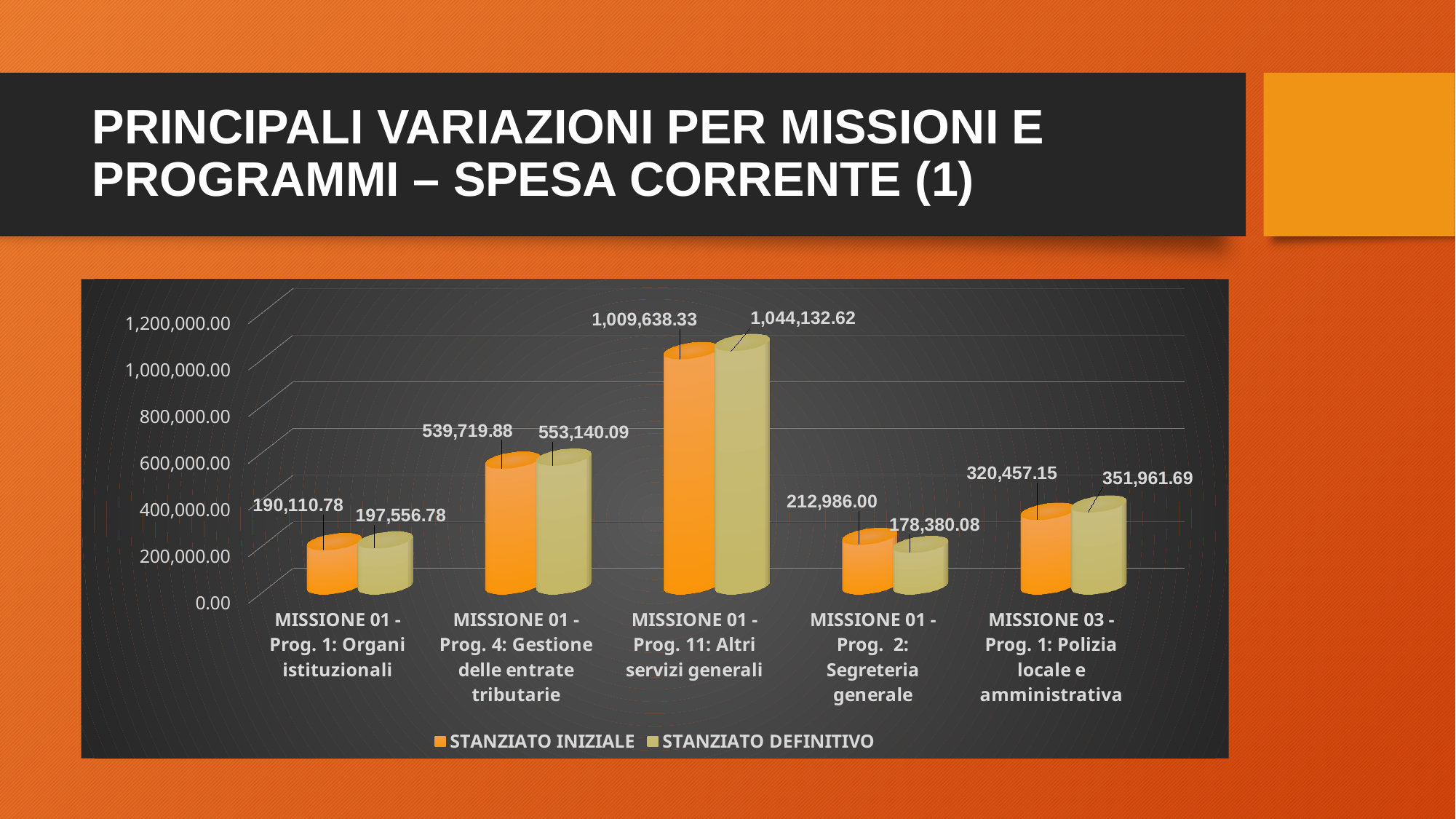
What is the STANZIATO INIZIALE value for MISSIONE 01 - Prog. 11: Altri servizi generali? 1,009,638.33 What is the difference between STANZIATO INIZIALE and STANZIATO DEFINITIVO for MISSIONE 01 - Prog. 2: Segreteria generale? 34,605.92 Which category has the lowest STANZIATO INIZIALE value? MISSIONE 01 - Prog. 1: Organi istituzionali What is the difference between STANZIATO DEFINITIVO and STANZIATO INIZIALE for MISSIONE 01 - Prog. 11: Altri servizi generali? 34,494.29 What is the STANZIATO DEFINITIVO value for MISSIONE 01 - Prog. 2: Segreteria generale? 178,380.08 For MISSIONE 01 - Prog. 2: Segreteria generale, which is larger, STANZIATO INIZIALE or STANZIATO DEFINITIVO? STANZIATO INIZIALE What is the STANZIATO DEFINITIVO value for MISSIONE 03 - Prog. 1: Polizia locale e amministrativa? 351,961.69 How many categories are shown on the x axis of the chart? 5 Is the STANZIATO INIZIALE value for MISSIONE 01 - Prog. 4: Gestione delle entrate tributarie greater or less than 600,000.00? less Which category has the highest STANZIATO DEFINITIVO value? MISSIONE 01 - Prog. 11: Altri servizi generali What kind of chart is shown on the slide? Bar chart How many series does the chart legend list? 2